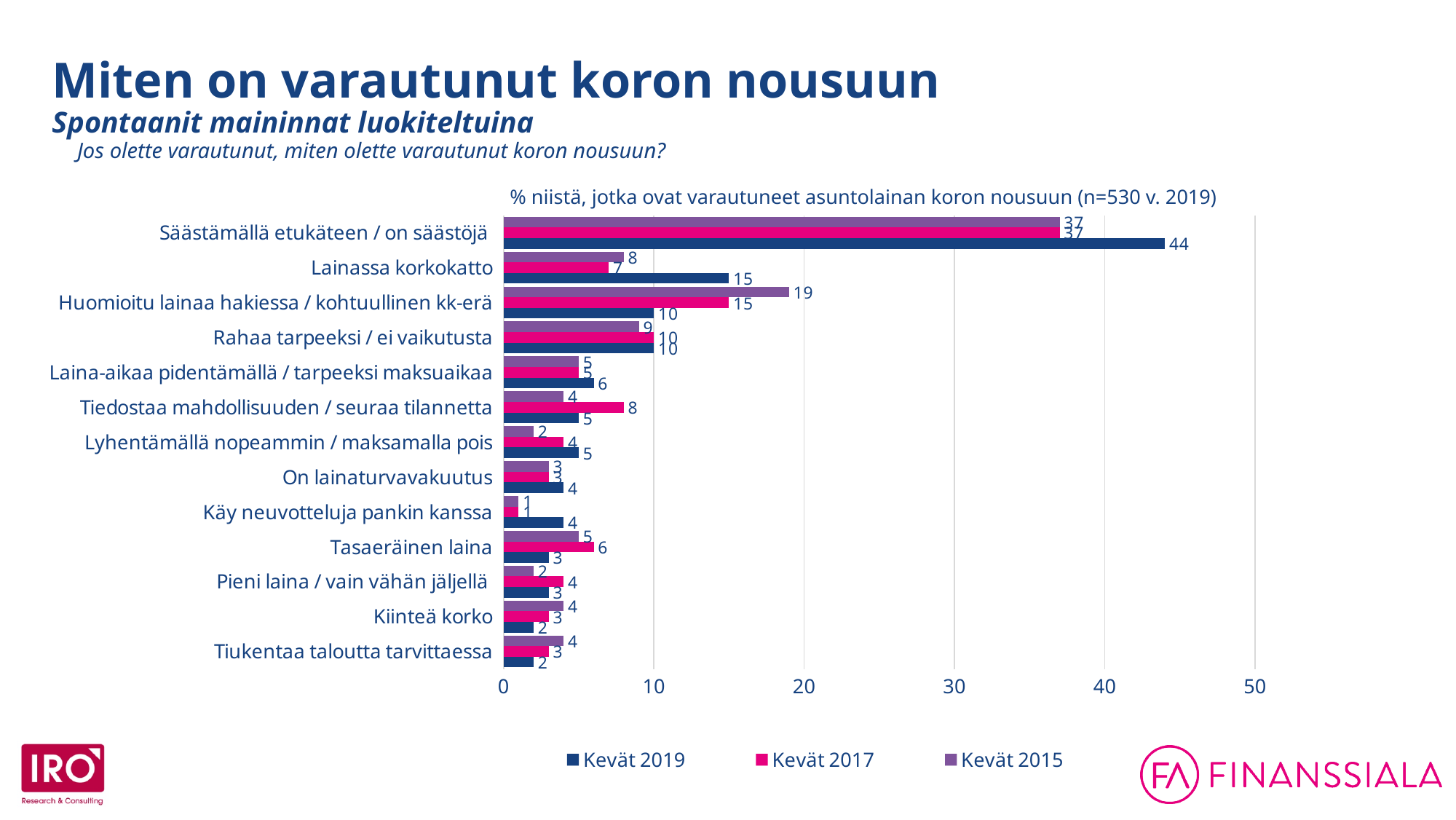
How many categories are shown on the chart? 13 What is the value for Lainassa korkokatto in the Kevät 2017 series? 7 What is the value for Säästämällä etukäteen / on säästöjä in the Kevät 2019 series? 44 Which category has the highest value in the Kevät 2019 series? Säästämällä etukäteen / on säästöjä What kind of chart is shown on the slide? Bar chart How many series does the legend list? 3 What is the difference between the Kevät 2019 and Kevät 2017 values for Säästämällä etukäteen / on säästöjä? 7 Is the Kevät 2019 value for Lainassa korkokatto greater or less than 10? greater Which series is shown in pink in the legend? Kevät 2017 Which is larger for Tiedostaa mahdollisuuden / seuraa tilannetta: the Kevät 2017 value or the Kevät 2019 value? Kevät 2017 What is the value for Huomioitu lainaa hakiessa / kohtuullinen kk-erä in the Kevät 2015 series? 19 Which category has the lowest value in the Kevät 2015 series? Käy neuvotteluja pankin kanssa